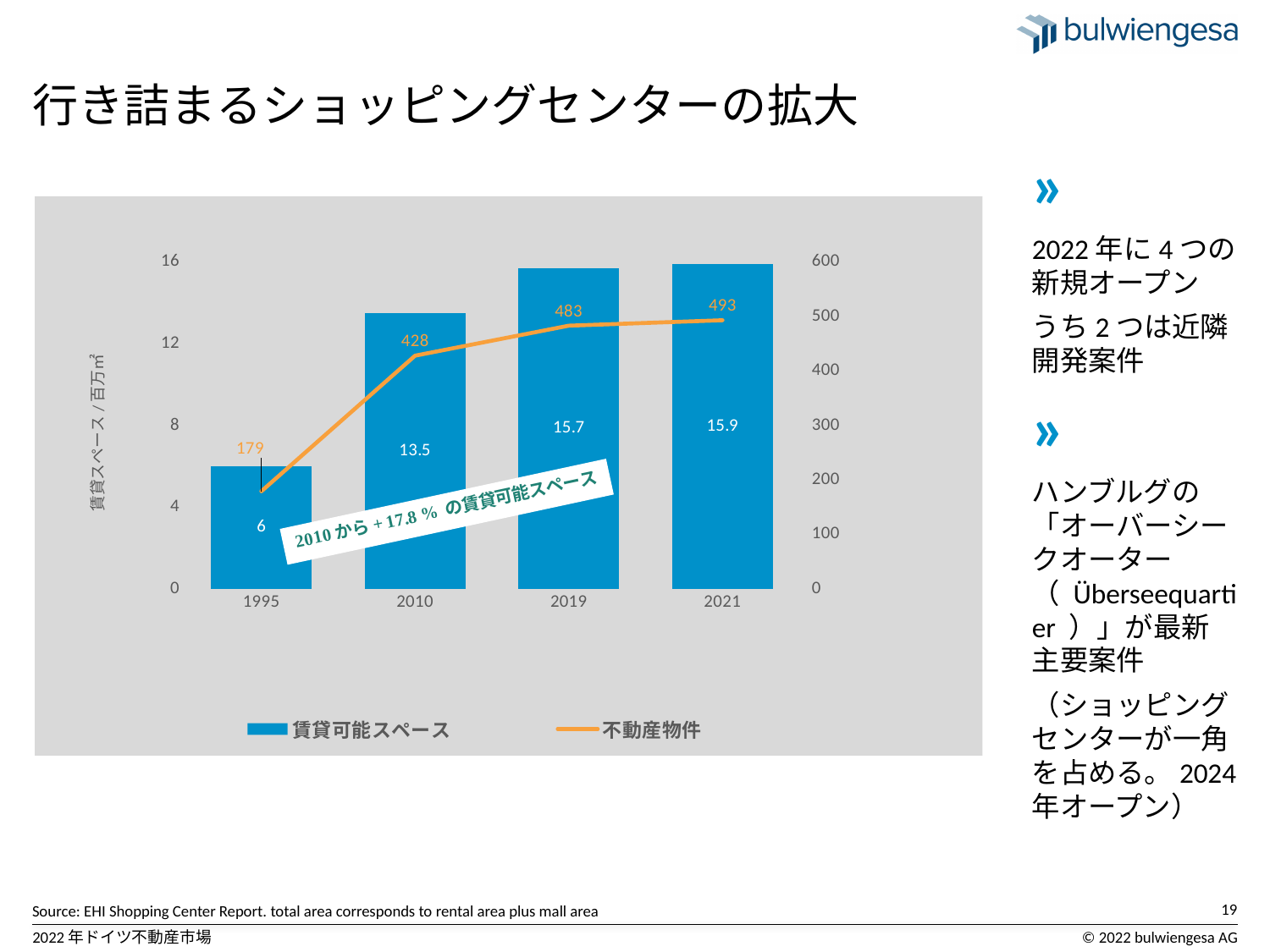
Which is larger, the 賃貸可能スペース value for 2010 or for 2019? 2019 What is the value of 賃貸可能スペース for 2010? 13.5 What is the value of 賃貸可能スペース for 1995? 6 Do the 不動産物件 values rise or fall from 1995 to 2021? rise Which year has the lowest value for 賃貸可能スペース? 1995 How many series does the chart legend list? 2 Which year has the highest value for 不動産物件? 2021 What is the value of 不動産物件 for 2021? 493 What is the difference between the 不動産物件 values for 2010 and 1995? 249 What is the difference between the 賃貸可能スペース values for 2021 and 2010? 2.4 What is the value of 不動産物件 for 2019? 483 How many years are shown on the x axis of the chart? 4